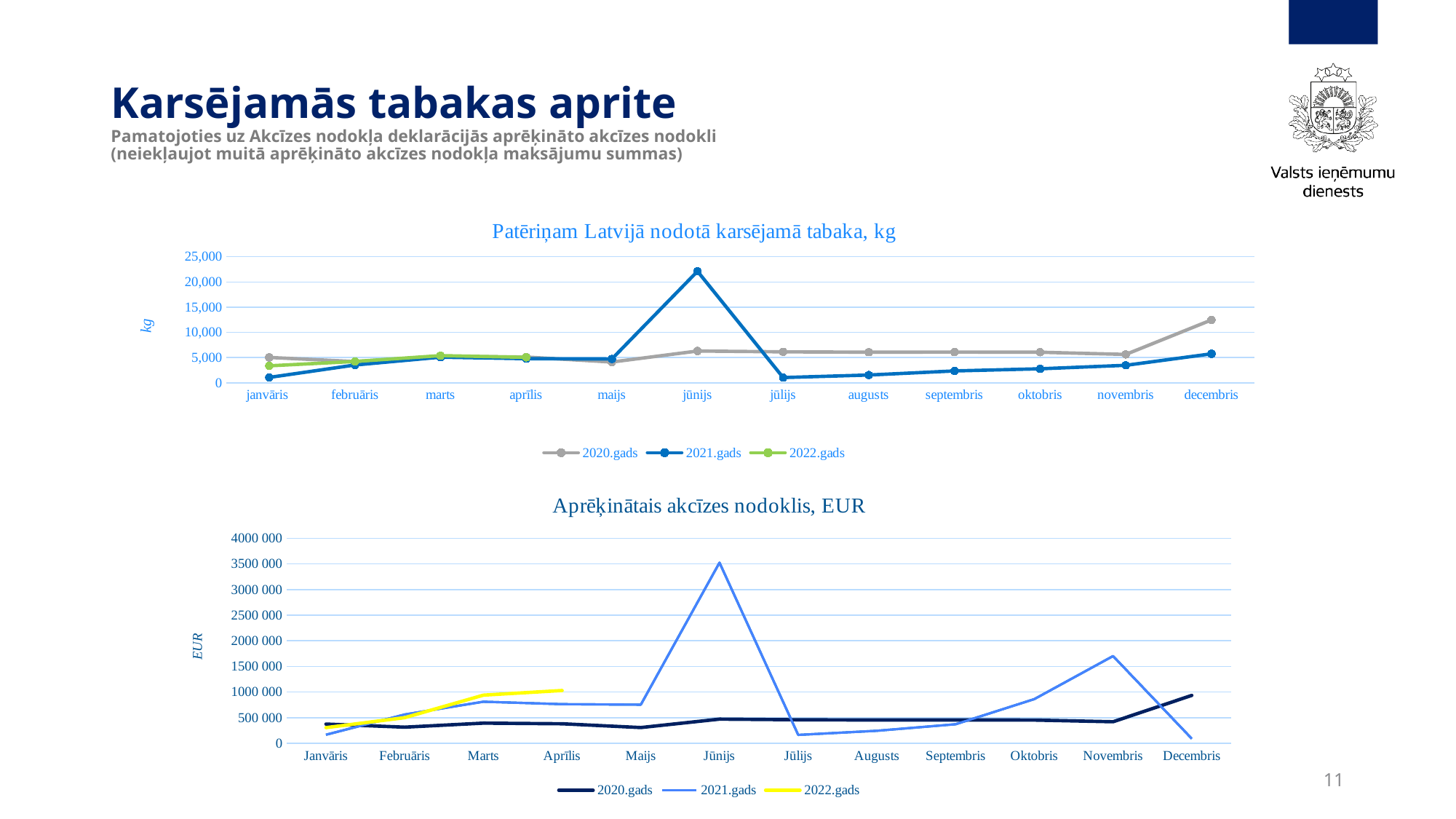
In the bottom chart "Aprēķinātais akcīzes nodoklis, EUR", is the 2021.gads value for Jūnijs greater or less than 3000 000? greater In the top chart "Patēriņam Latvijā nodotā karsējamā tabaka, kg", is the 2021.gads value for jūlijs greater or less than 5,000? less In the bottom chart "Aprēķinātais akcīzes nodoklis, EUR", which series has the larger value in Novembris, 2020.gads or 2021.gads? 2021.gads In the bottom chart "Aprēķinātais akcīzes nodoklis, EUR", does the 2021.gads series rise or fall from Jūnijs to Jūlijs? fall In the top chart "Patēriņam Latvijā nodotā karsējamā tabaka, kg", in which month does the 2021.gads series reach its highest value? jūnijs In the top chart "Patēriņam Latvijā nodotā karsējamā tabaka, kg", is the 2021.gads value for jūnijs greater or less than 20,000? greater What kind of chart is the top chart titled "Patēriņam Latvijā nodotā karsējamā tabaka, kg"? line chart How many series does the legend of the bottom chart "Aprēķinātais akcīzes nodoklis, EUR" list? 3 In the top chart "Patēriņam Latvijā nodotā karsējamā tabaka, kg", in which month does the 2020.gads series reach its highest value? decembris In the top chart "Patēriņam Latvijā nodotā karsējamā tabaka, kg", which colour is used for the 2022.gads series? green In the bottom chart "Aprēķinātais akcīzes nodoklis, EUR", in which month does the 2021.gads series reach its highest value? Jūnijs How many months are shown on the x axis of the top chart "Patēriņam Latvijā nodotā karsējamā tabaka, kg"? 12